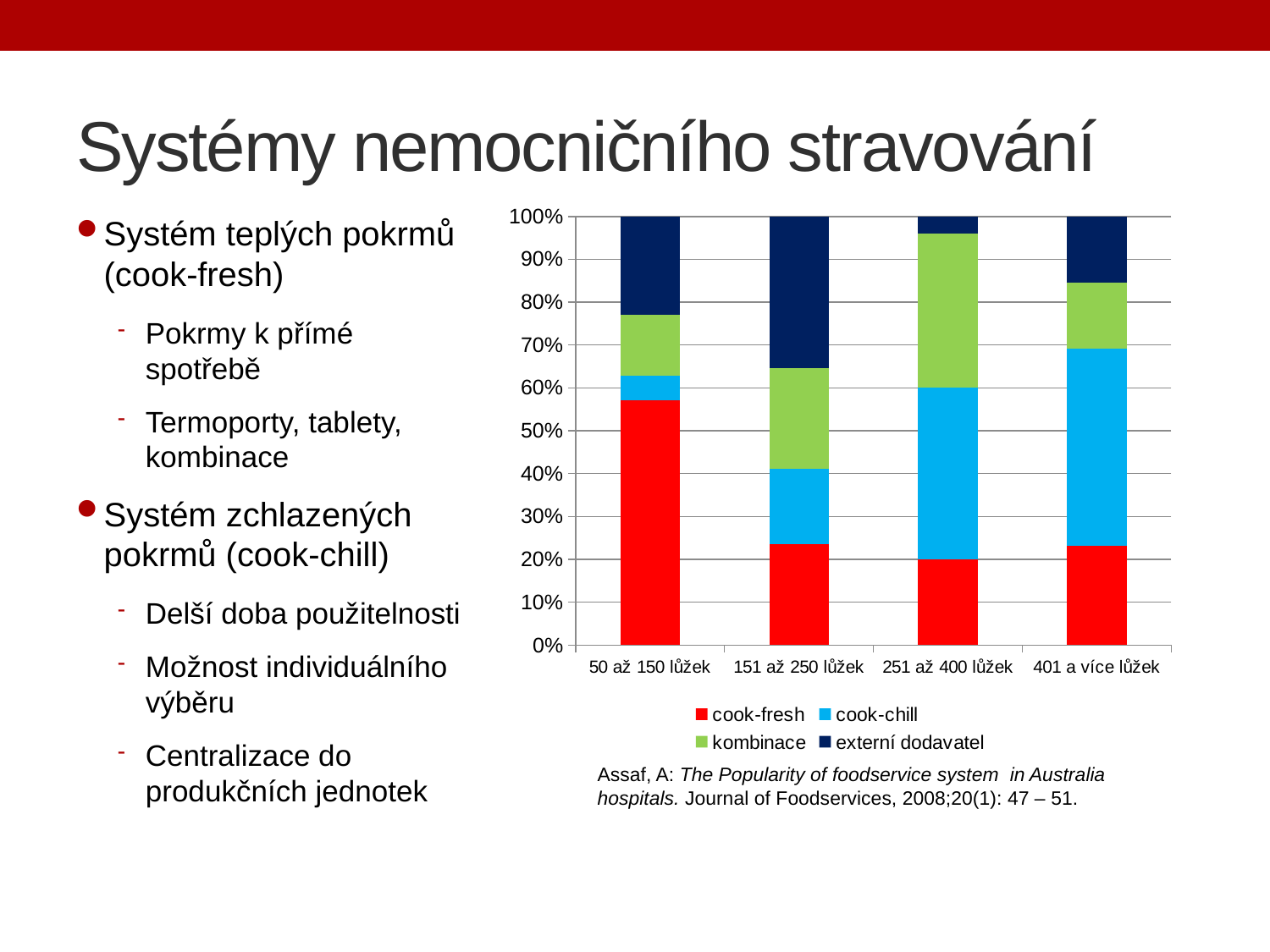
Which category has the smallest externí dodavatel share? 251 až 400 lůžek Is the cook-fresh value for 251 až 400 lůžek greater or less than 30%? less Which category has the larger cook-chill share: 50 až 150 lůžek or 401 a více lůžek? 401 a více lůžek Which category has the largest externí dodavatel share? 151 až 250 lůžek Which category has the largest cook-fresh share? 50 až 150 lůžek Is the cook-fresh value for 50 až 150 lůžek greater or less than 50%? greater Which category has the larger kombinace share: 251 až 400 lůžek or 401 a více lůžek? 251 až 400 lůžek Is the cook-fresh value for 151 až 250 lůžek greater or less than 30%? less What kind of chart is shown on the slide? stacked bar chart Which legend entry is shown in dark blue? externí dodavatel How many hospital size categories are shown on the x axis of the chart? 4 How many series does the chart legend list? 4